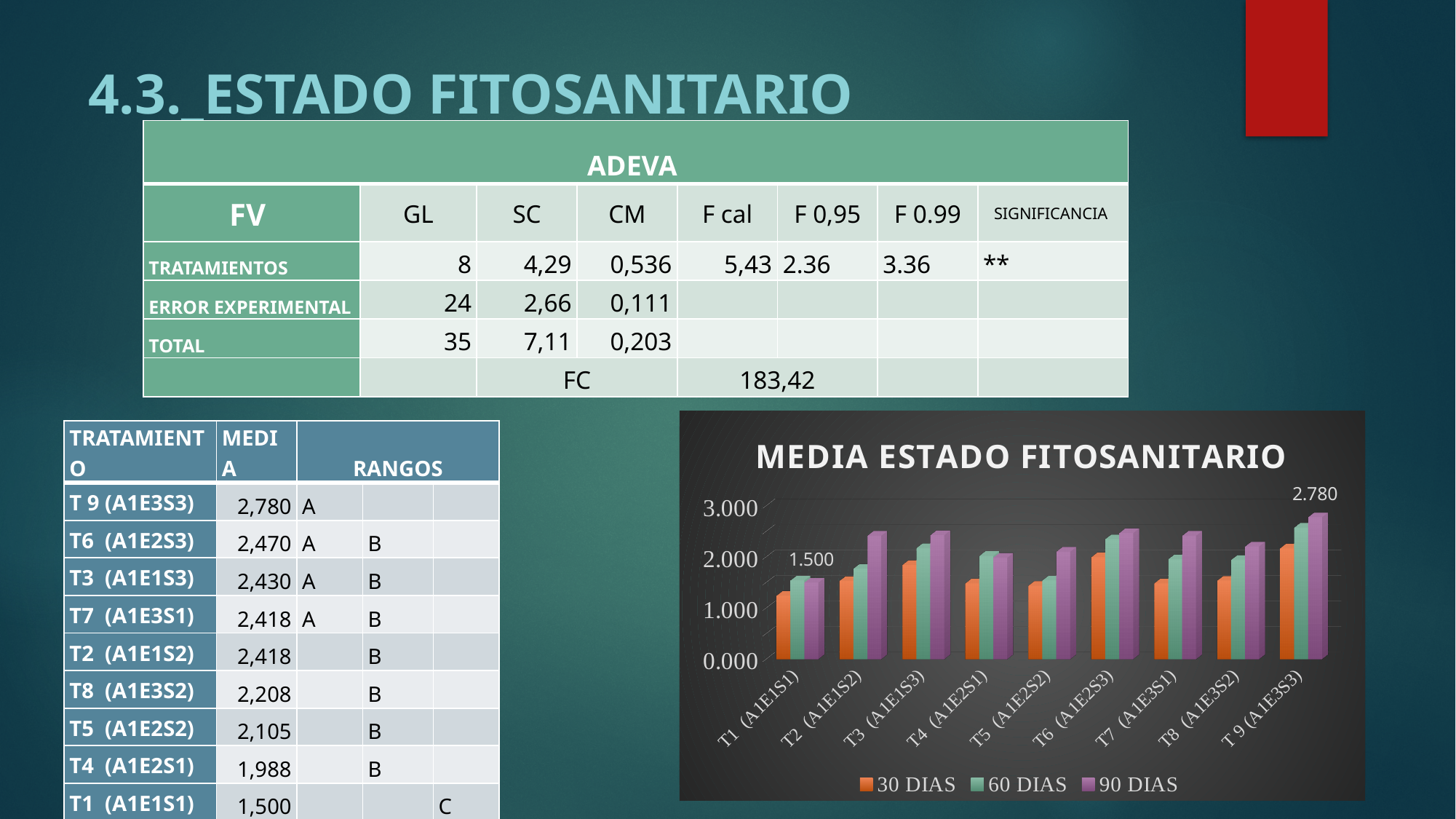
In the MEDIA ESTADO FITOSANITARIO chart, which treatment has the tallest 90 DIAS bar? T 9 (A1E3S3) In the MEDIA ESTADO FITOSANITARIO chart, which treatment has the shortest 90 DIAS bar? T1 (A1E1S1) What data label is printed above the bars for T1 (A1E1S1) in the MEDIA ESTADO FITOSANITARIO chart? 1.500 How many treatment categories are plotted on the x axis of the MEDIA ESTADO FITOSANITARIO chart? 9 What is the difference between the two data labels shown in the MEDIA ESTADO FITOSANITARIO chart (2.780 and 1.500)? 1.280 What type of chart is shown under the title MEDIA ESTADO FITOSANITARIO? bar chart In the MEDIA ESTADO FITOSANITARIO chart, which colour represents the 90 DIAS series? purple In the MEDIA ESTADO FITOSANITARIO chart, is the 30 DIAS value for T1 (A1E1S1) greater or less than 2.000? less In the MEDIA ESTADO FITOSANITARIO chart, is the 90 DIAS value for T6 (A1E2S3) greater or less than 2.000? greater In the MEDIA ESTADO FITOSANITARIO chart, which is larger: the 90 DIAS bar for T 9 (A1E3S3) or the 90 DIAS bar for T1 (A1E1S1)? T 9 (A1E3S3) What data label is printed above the bars for T 9 (A1E3S3) in the MEDIA ESTADO FITOSANITARIO chart? 2.780 How many series does the legend of the MEDIA ESTADO FITOSANITARIO chart list? 3